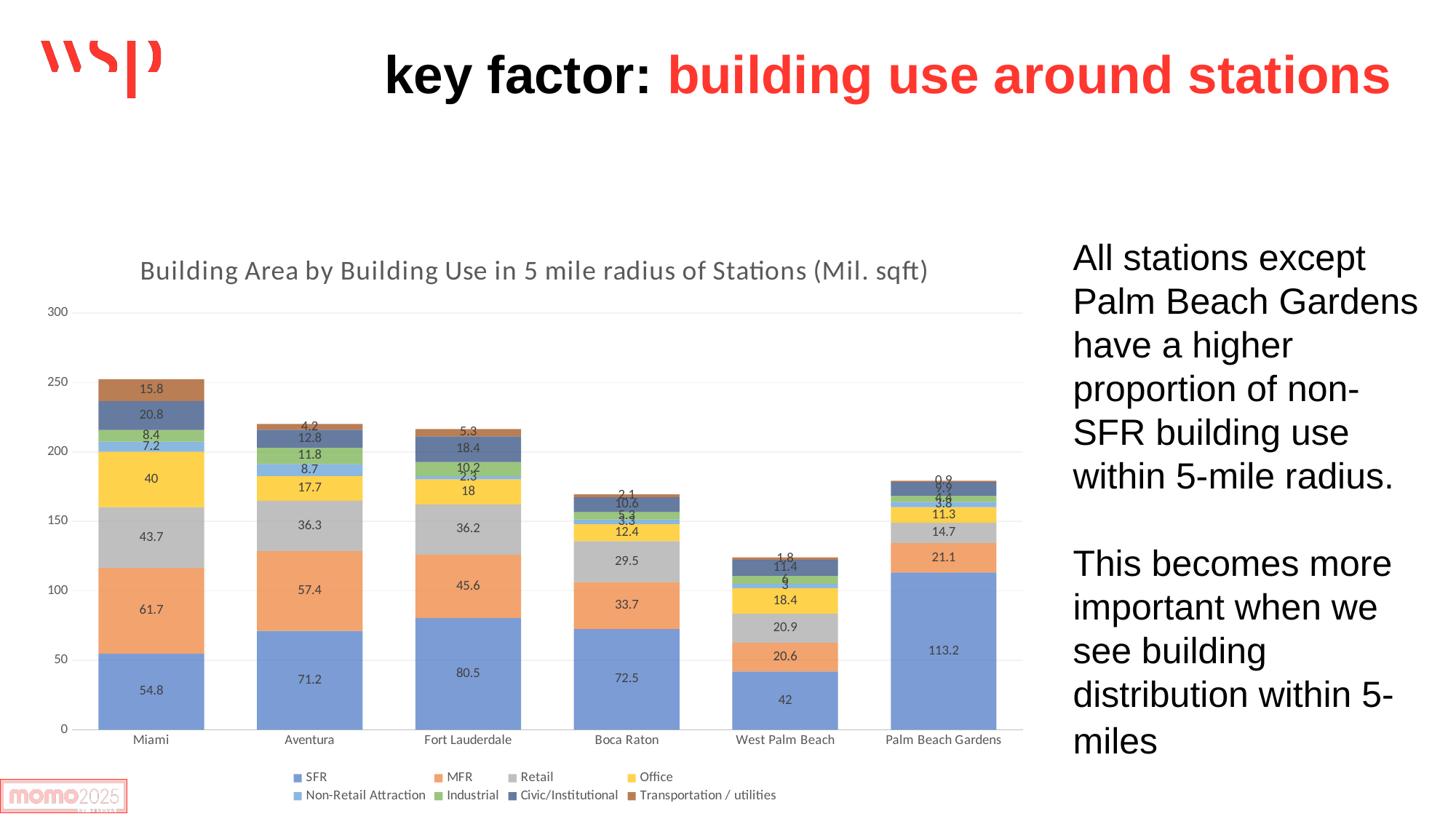
How many stations are shown on the x axis? 6 What is the SFR value for Miami? 54.8 What is the difference between the SFR values for Fort Lauderdale and Boca Raton? 8 What is the SFR value for Palm Beach Gardens? 113.2 What is the MFR value for Aventura? 57.4 Which station has the highest SFR value? Palm Beach Gardens Is the total stacked bar for West Palm Beach greater or less than 150? less Which station has the lowest SFR value? West Palm Beach Which station has the highest Office value? Miami Which is larger, the MFR value for Miami or the MFR value for Aventura? Miami How many series does the legend list? 8 What is the Retail value for Fort Lauderdale? 36.2